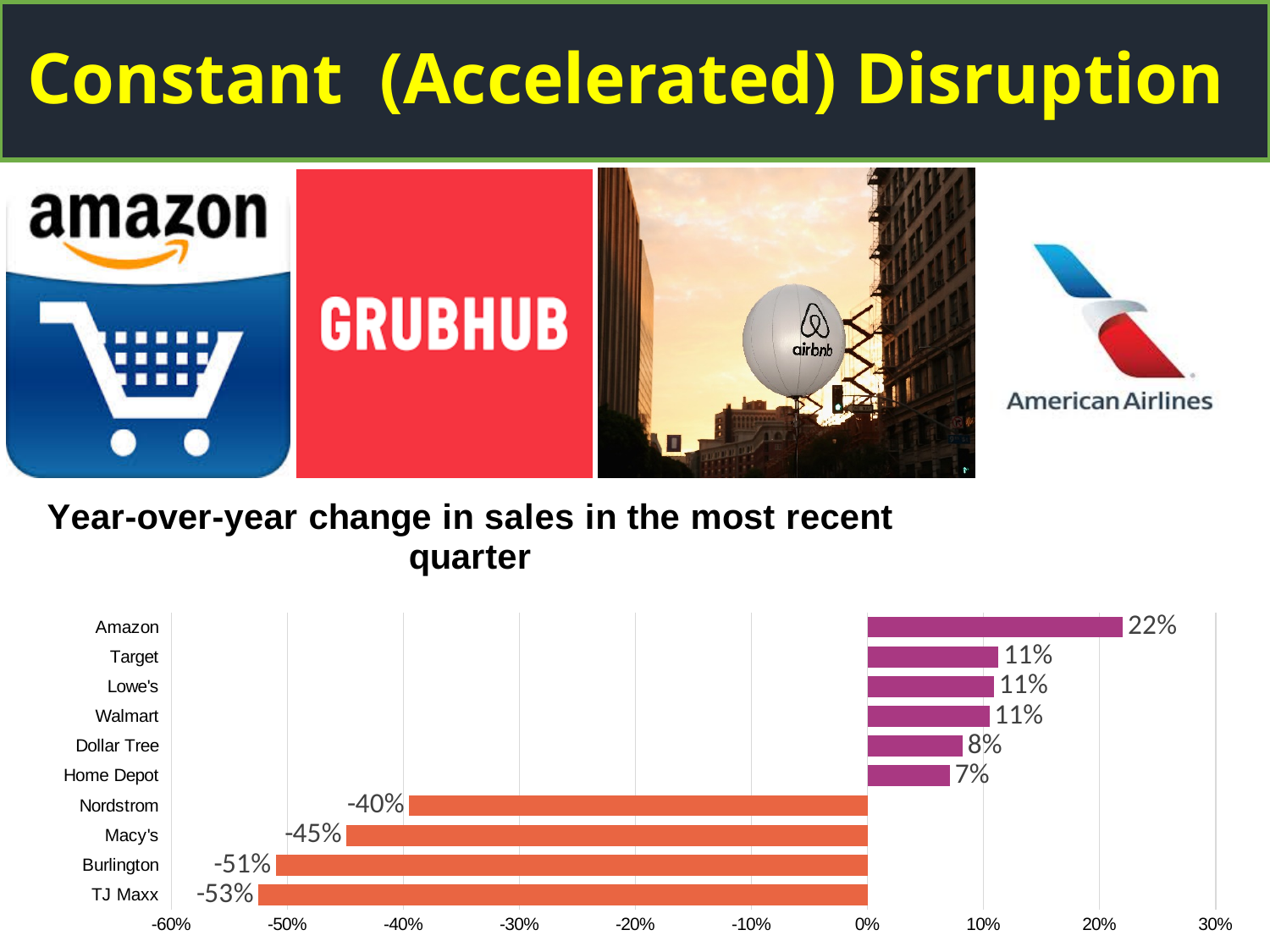
Is the value for Nordstrom greater or less than -30%? less What is the difference between Amazon's and Target's year-over-year change in sales? 11 percentage points What is the year-over-year change in sales for Amazon? 22% What is the year-over-year change in sales for Macy's? -45% Which has a larger year-over-year change in sales, Dollar Tree or Home Depot? Dollar Tree What is the title of the chart? Year-over-year change in sales in the most recent quarter What kind of chart is shown on the slide? Bar chart How many companies are shown in the chart? 10 What is the year-over-year change in sales for Home Depot? 7% What is the year-over-year change in sales for TJ Maxx? -53% Which company has the highest year-over-year change in sales? Amazon Which company has the lowest year-over-year change in sales? TJ Maxx